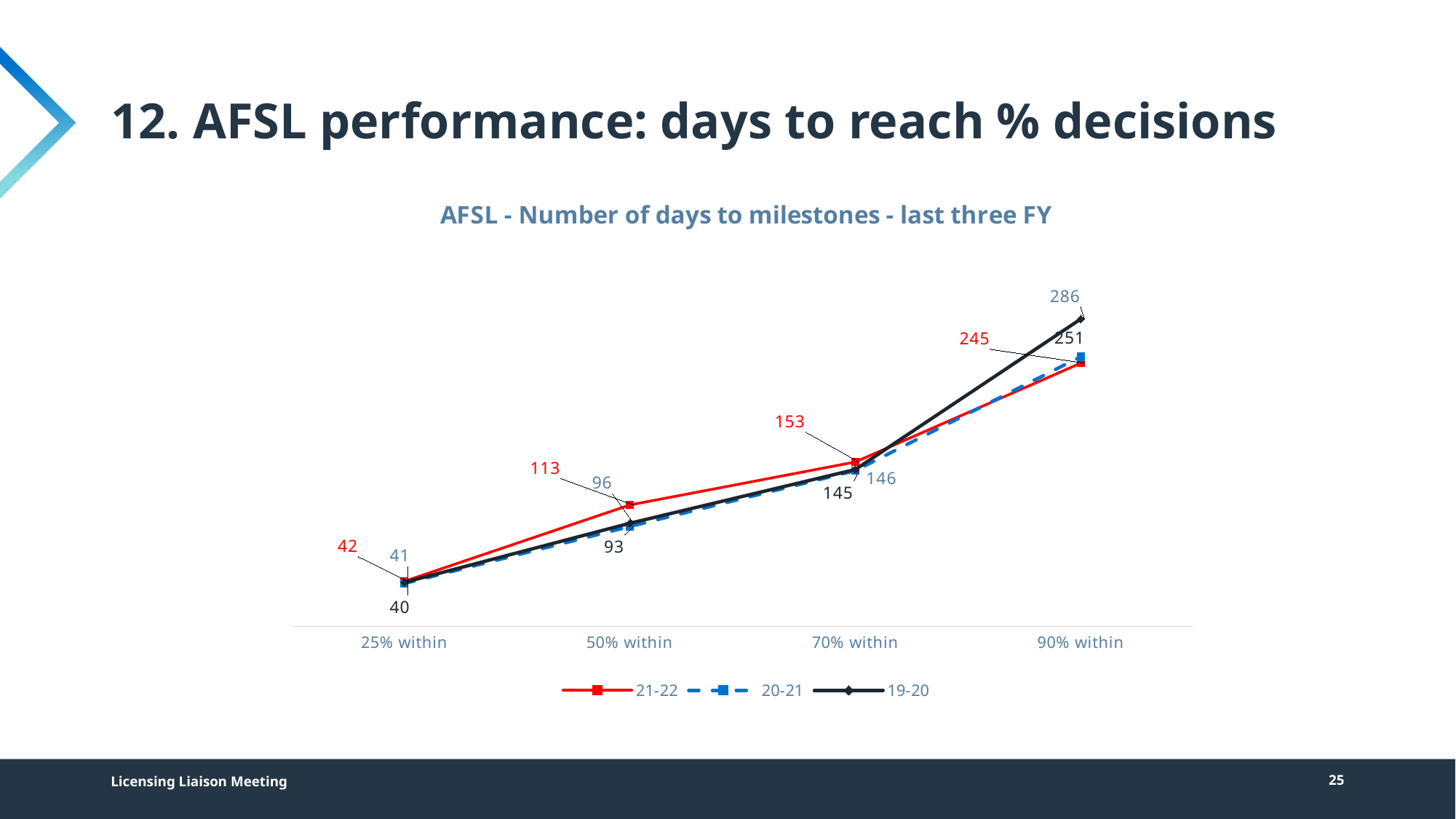
How many series does the legend list? 3 What is the value for the 21-22 series at 50% within? 113 How many milestone categories are shown on the x axis? 4 What is the difference between the 21-22 and 19-20 values at 50% within? 17 At 50% within, which series has the larger value, 21-22 or 20-21? 21-22 What is the value for the 19-20 series at 25% within? 41 What kind of chart is shown on the slide? Line chart What is the value for the 21-22 series at 90% within? 245 What is the value for the 20-21 series at 50% within? 93 What is the title of the chart? AFSL - Number of days to milestones - last three FY What is the value for the 21-22 series at 70% within? 153 Do the values for the 21-22 series rise or fall from 25% within to 90% within? Rise